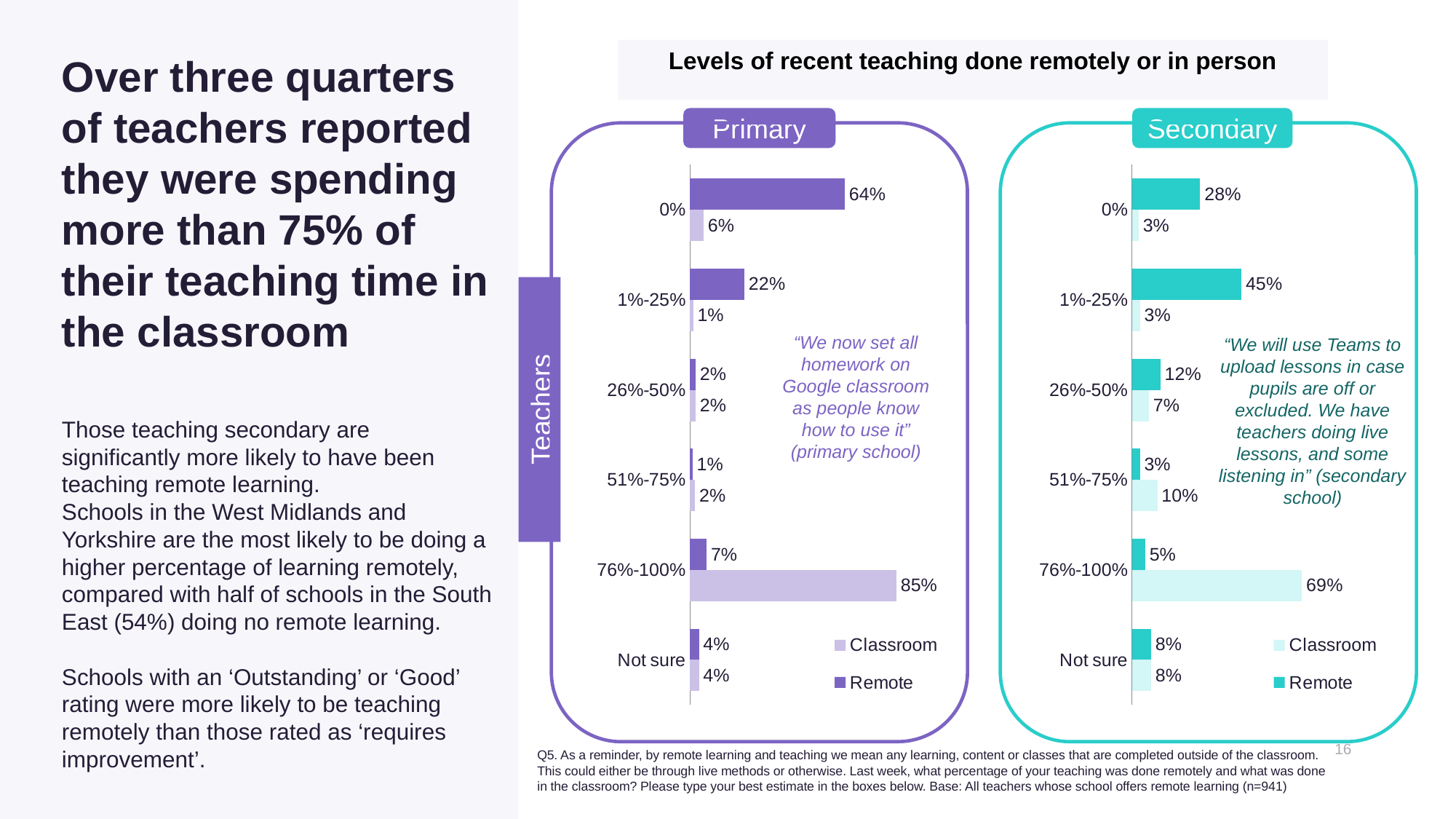
In the Secondary chart, which is larger for 26%-50%: Remote or Classroom? Remote In the Primary chart, which category has the lowest Remote value? 51%-75% What type of chart is the Primary chart? Bar chart In the Secondary chart, what is the Remote value for 1%-25%? 45% What is the difference between the Primary and Secondary Classroom values for 76%-100%? 16% How many categories are shown in the Primary chart? 6 In the Secondary chart, what is the Classroom value for 76%-100%? 69% In the Primary chart, what is the Classroom value for 76%-100%? 85% In the Secondary chart, which category has the highest Remote value? 1%-25% What is the title shown above the two charts? Levels of recent teaching done remotely or in person How many series does the legend of the Secondary chart list? 2 In the Primary chart, what is the Remote value for 0%? 64%